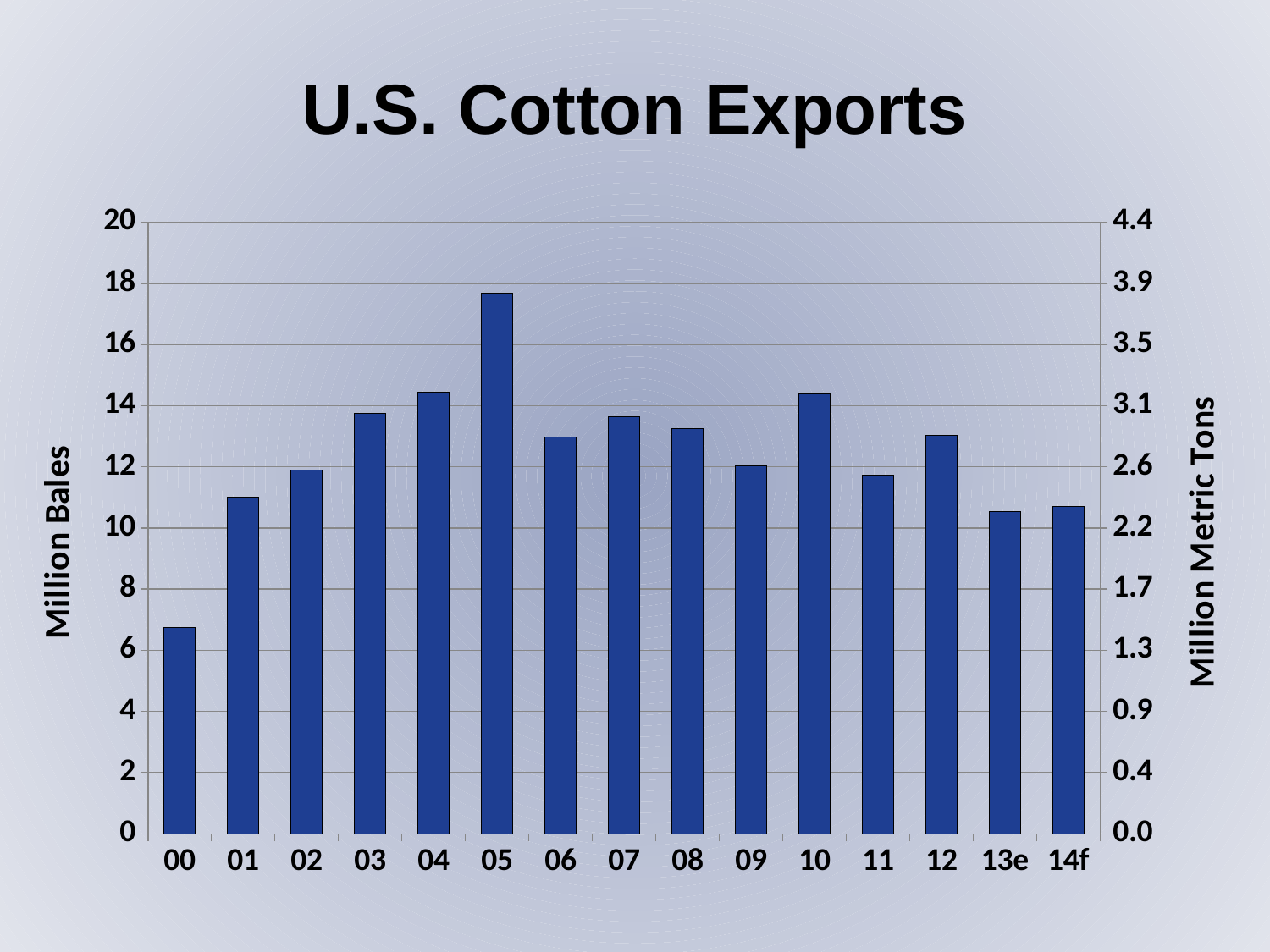
How many years (categories) are shown on the x axis? 15 Do exports rise or fall from 00 to 05? rise What is the label of the left vertical axis? Million Bales What type of chart is shown on the slide? bar chart Is the value for 00 greater or less than 8 million bales? less Is the value for 05 greater or less than 16 million bales? greater Which year has higher exports, 04 or 01? 04 Which year has the lowest cotton exports? 00 Which year has the highest cotton exports? 05 What is the title of the chart? U.S. Cotton Exports Is the value for 09 greater or less than 10 million bales? greater Which year has higher exports, 03 or 13e? 03